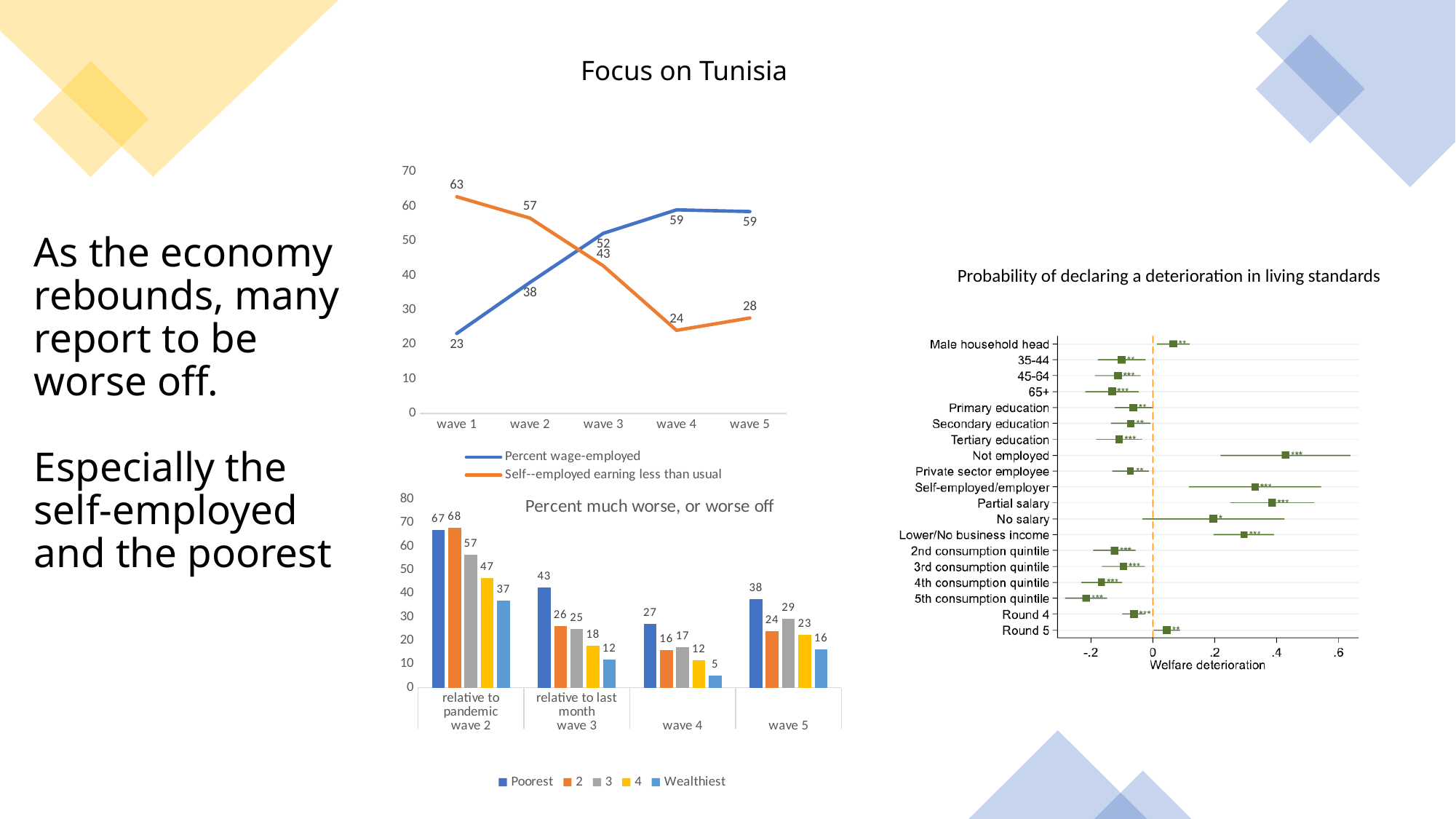
In the top line chart, what is the value for Percent wage-employed at wave 1? 23 In the 'Percent much worse, or worse off' chart, which is larger at wave 5: group 3 or group 4? 3 In the 'Percent much worse, or worse off' chart, what is the difference between the Poorest and Wealthiest values for relative to pandemic wave 2? 30 In the top line chart, what is the difference between the two series at wave 5? 31 In the 'Percent much worse, or worse off' chart, which group has the lowest value at wave 4? Wealthiest In the 'Percent much worse, or worse off' chart, what is the value for the Poorest group at wave 5? 38 What kind of chart is 'Percent much worse, or worse off'? bar chart In the top line chart, does the Self-employed earning less than usual series rise or fall from wave 1 to wave 4? fall In the 'Probability of declaring a deterioration in living standards' chart, which category has the highest welfare deterioration estimate? Not employed In the top line chart, how many series does the legend list? 2 In the top line chart, what is the value for Self-employed earning less than usual at wave 4? 24 In the 'Probability of declaring a deterioration in living standards' chart, is the estimate for Self-employed/employer greater or less than .2? greater